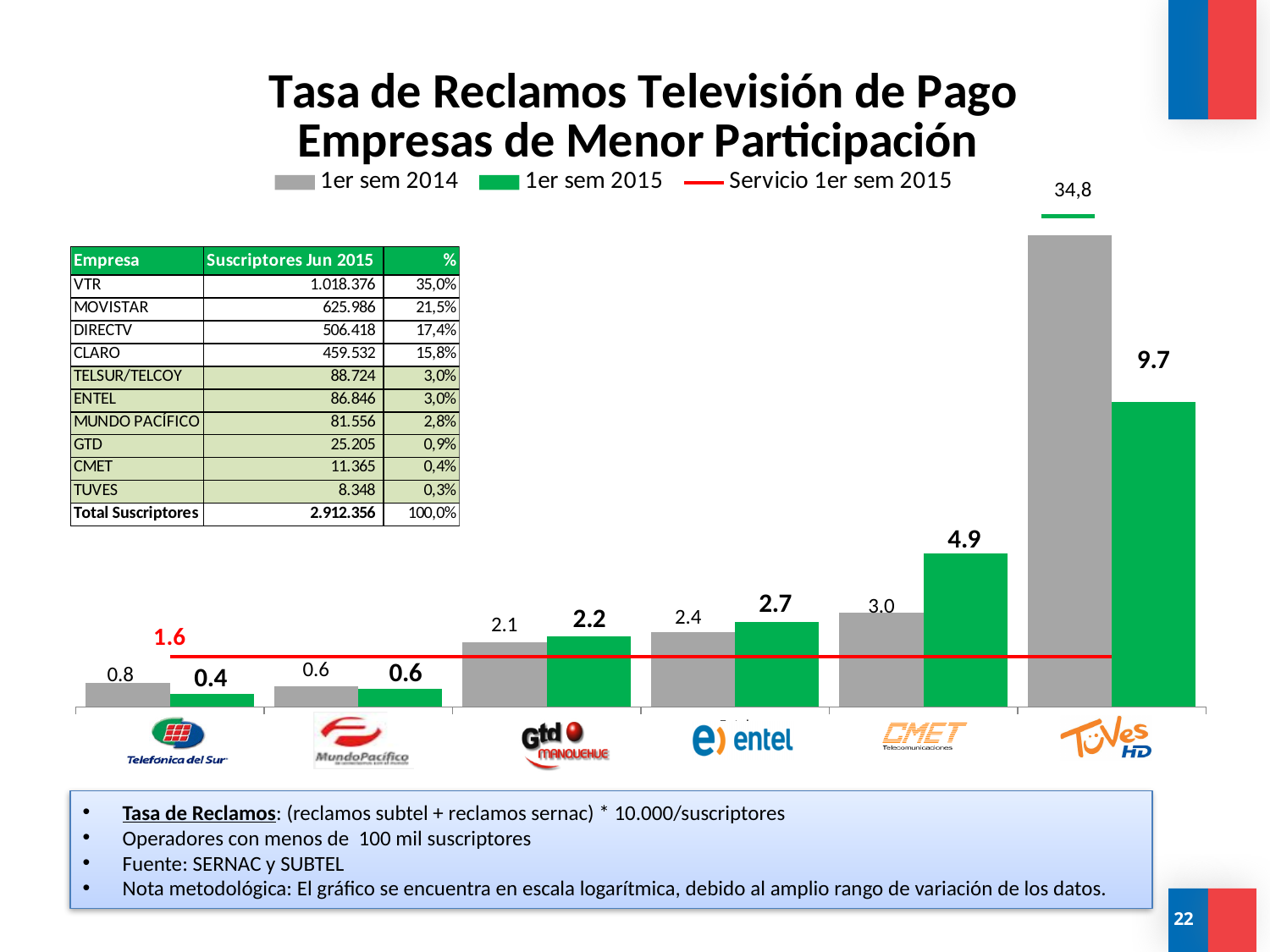
What kind of chart is shown on the slide? Combination bar and line chart How many series does the legend list? 3 Which company has the lowest 1er sem 2015 value? Telefónica del Sur What is the 1er sem 2015 value for CMET? 4.9 Which company has the highest 1er sem 2015 value? TuVes What is the 1er sem 2014 value for TuVes? 34,8 Which is larger, the 1er sem 2014 value for Gtd Manquehue or for Entel? Entel What value does the Servicio 1er sem 2015 line mark? 1.6 How many companies are shown on the x axis of the chart? 6 Do the 1er sem 2015 values rise or fall from left to right across the companies? Rise What is the 1er sem 2014 value for Entel? 2.4 What is the difference between the 1er sem 2015 and 1er sem 2014 values for CMET? 1.9